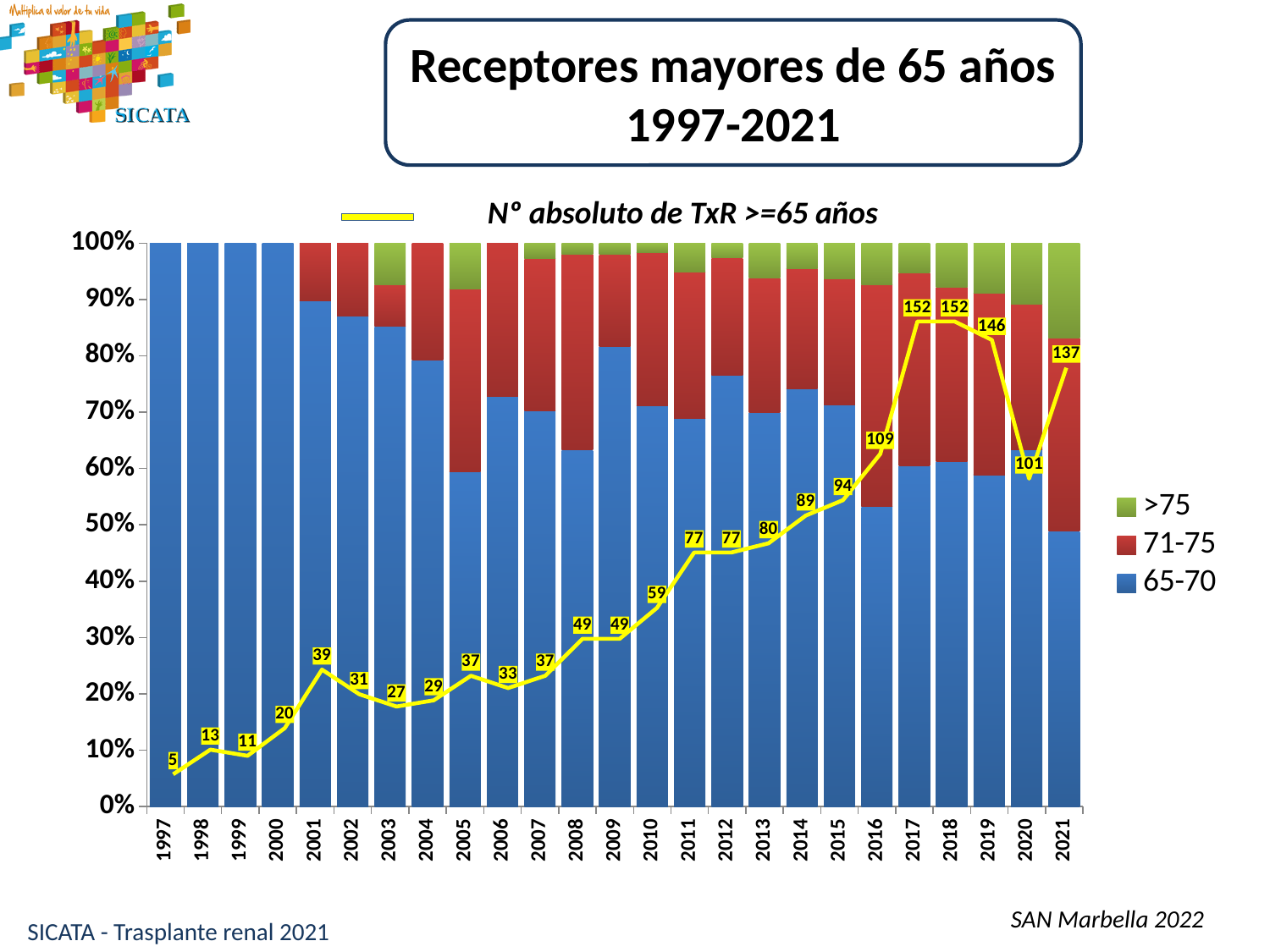
What is the absolute number of TxR >=65 años shown for 2021? 137 What kind of chart is shown on the slide? Stacked bar chart with a line How many years are shown on the x axis of the chart? 25 Does the absolute number of TxR >=65 años generally rise or fall from 1997 to 2017? Rise Is the share of the 65-70 group in 2001 greater or less than 80%? greater What is the difference between the absolute number of TxR >=65 años in 2020 and in 2021? 36 How many age groups does the legend on the right of the chart list? 3 Which year has a higher absolute number of TxR >=65 años, 2019 or 2020? 2019 What is the absolute number of TxR >=65 años shown for 2010? 59 Is the share of the 65-70 group in 2016 greater or less than 60%? less What is the absolute number of TxR >=65 años shown for 2017? 152 In which year is the absolute number of TxR >=65 años lowest? 1997